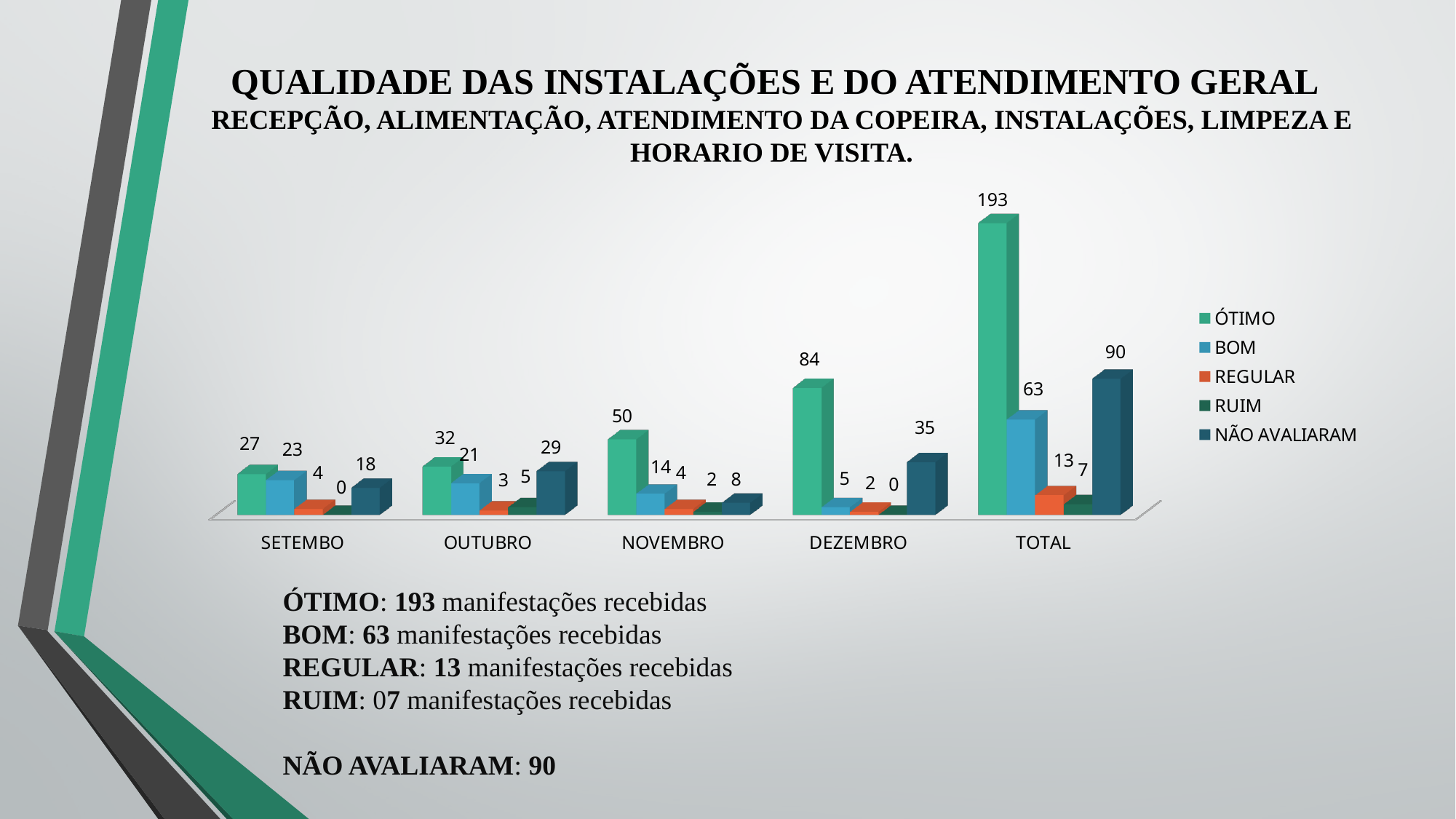
How many series does the legend list? 5 Which is larger for NOVEMBRO: the BOM value or the NÃO AVALIARAM value? BOM What is the difference between the ÓTIMO and BOM values for TOTAL? 130 How many categories are shown on the x axis? 5 What is the ÓTIMO value for DEZEMBRO? 84 What is the BOM value for OUTUBRO? 21 What is the REGULAR value for TOTAL? 13 What is the NÃO AVALIARAM value for SETEMBO? 18 Which category has the lowest BOM value? DEZEMBRO Which month (excluding TOTAL) has the highest ÓTIMO value? DEZEMBRO What kind of chart is shown on the slide? Bar chart Does the ÓTIMO value rise or fall from SETEMBO to DEZEMBRO? Rise